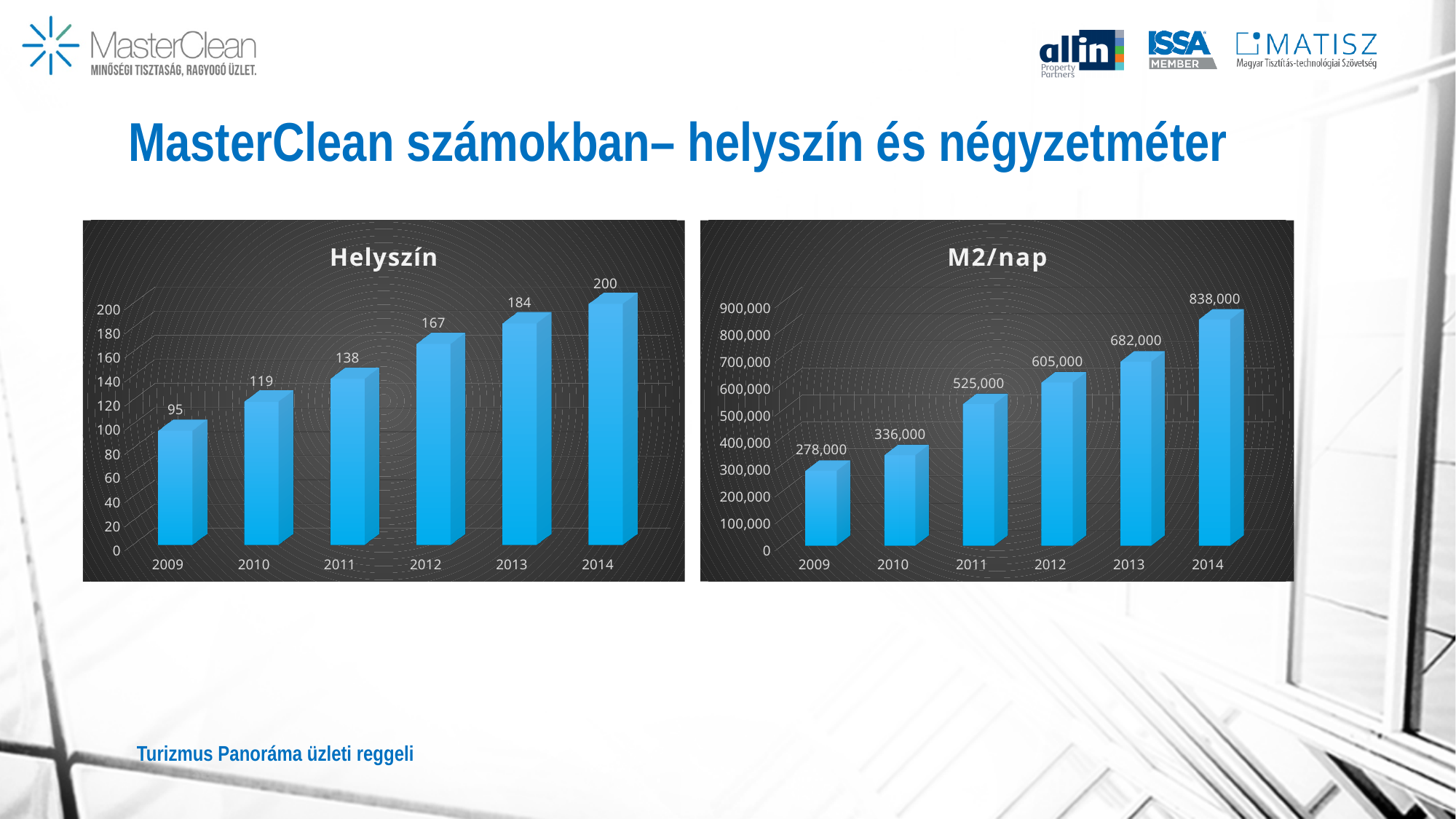
In the M2/nap chart, what is the difference between the values for 2012 and 2011? 80,000 In the Helyszín chart, which year has the highest value? 2014 In the Helyszín chart, what is the value for 2011? 138 What is the title of the chart on the left side of the slide? Helyszín In the Helyszín chart, which is larger, the value for 2012 or the value for 2010? 2012 In the M2/nap chart, is the value for 2014 greater or less than 800,000? greater In the M2/nap chart, do the values rise or fall from 2009 to 2014? rise In the M2/nap chart, what is the value for 2013? 682,000 In the Helyszín chart, what is the difference between the values for 2014 and 2009? 105 What kind of chart is the M2/nap chart? bar chart In the M2/nap chart, which year has the lowest value? 2009 How many years are shown on the x axis of the Helyszín chart? 6